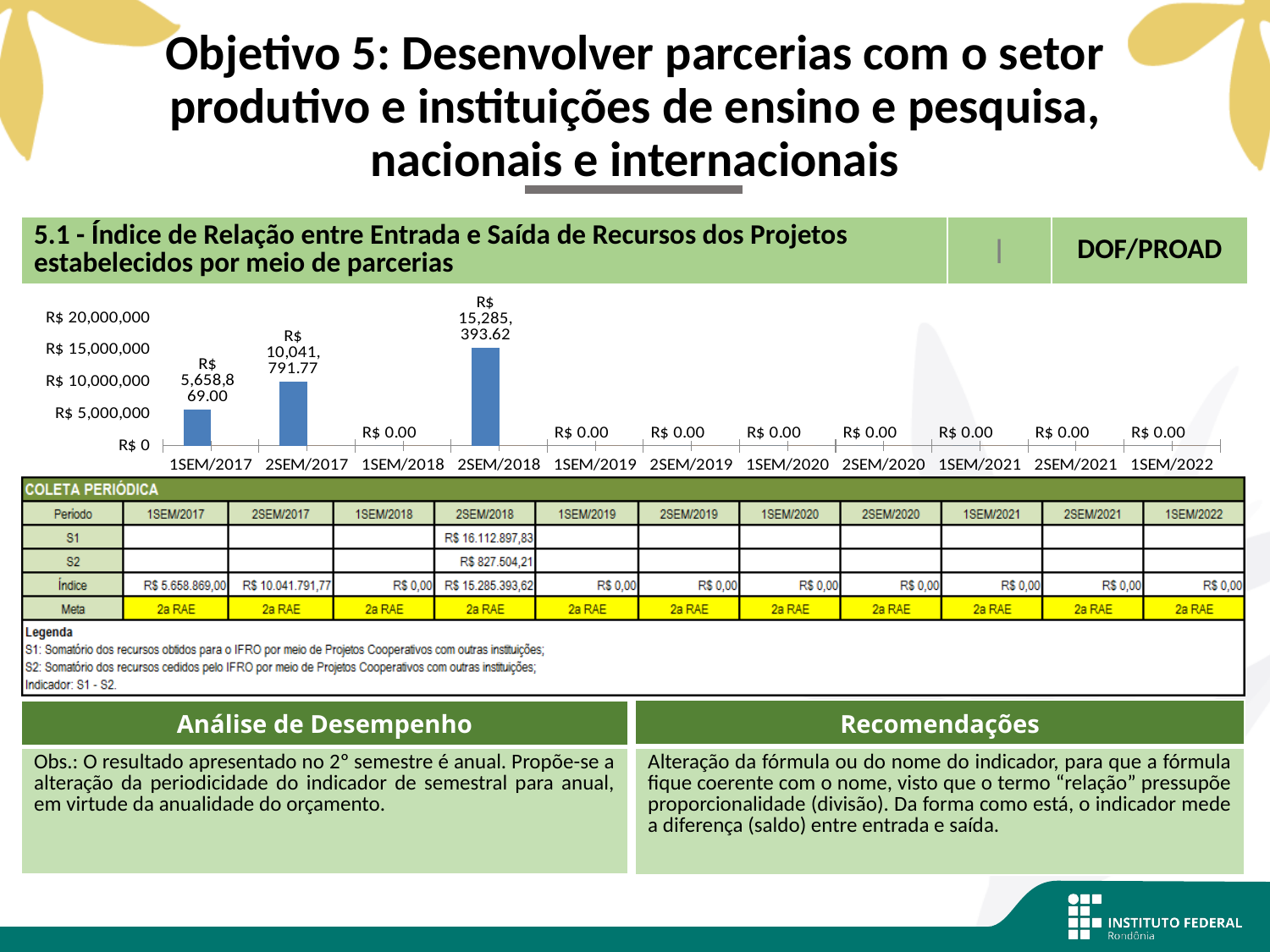
What is the value shown for 1SEM/2018 in the chart? R$ 0.00 Which is larger, the value for 2SEM/2017 or the value for 1SEM/2017? 2SEM/2017 How many periods in the chart show a value of R$ 0.00? 8 What is the value shown for 2SEM/2017 in the chart? R$ 10,041,791.77 Which period has the highest value in the chart? 2SEM/2018 Is the value for 2SEM/2017 greater or less than R$ 5,000,000? greater What type of chart is shown on the slide? bar chart Does the value rise or fall from 1SEM/2017 to 2SEM/2017? rise How many periods (categories) are shown on the x axis of the chart? 11 What is the value shown for 1SEM/2017 in the chart? R$ 5,658,869.00 What is the value shown for 2SEM/2018 in the chart? R$ 15,285,393.62 What is the difference between the values for 2SEM/2018 and 2SEM/2017? R$ 5,243,601.85